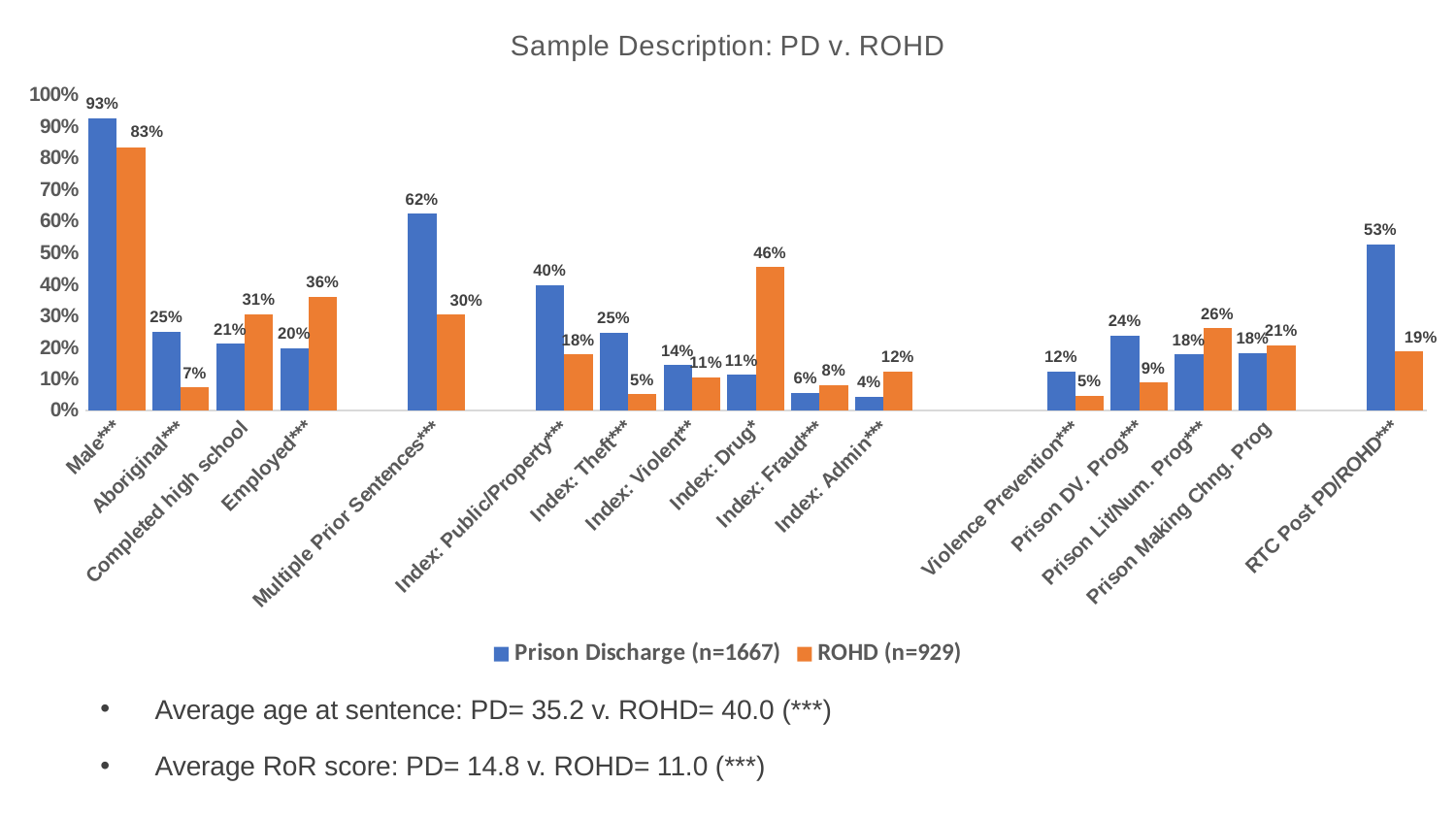
How many categories are shown on the x axis? 16 What is the ROHD (n=929) value for Index: Drug*? 46% How many series does the legend list? 2 What is the title of the chart? Sample Description: PD v. ROHD What kind of chart is shown on the slide? Bar chart Which category has the highest Prison Discharge (n=1667) value? Male*** For Index: Drug*, which series has the larger value, Prison Discharge (n=1667) or ROHD (n=929)? ROHD (n=929) What is the difference between the Prison Discharge (n=1667) and ROHD (n=929) values for RTC Post PD/ROHD***? 34% Is the Prison Discharge (n=1667) value for Index: Public/Property*** greater or less than 30%? greater Which category has the lowest Prison Discharge (n=1667) value? Index: Admin*** What is the ROHD (n=929) value for Employed***? 36% What is the Prison Discharge (n=1667) value for Multiple Prior Sentences***? 62%